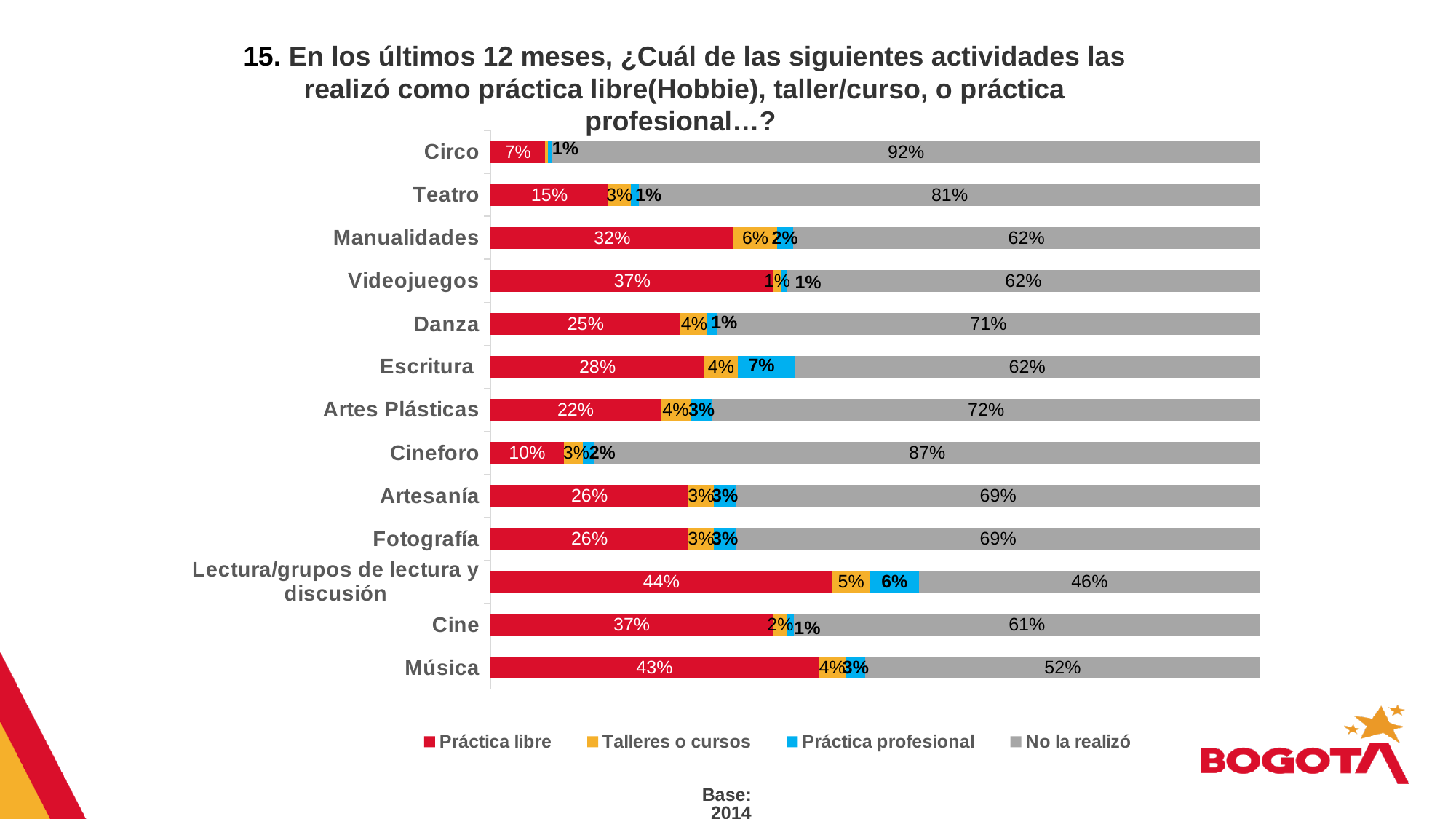
What is the 'Práctica profesional' value for Escritura? 7% Which activity has the lowest 'No la realizó' value? Lectura/grupos de lectura y discusión How many series does the legend list? 4 Which activity has the highest 'Práctica libre' value? Lectura/grupos de lectura y discusión What is the 'No la realizó' value for Circo? 92% How many activities are listed on the chart? 13 Which is larger: the 'Práctica libre' value for Videojuegos or for Manualidades? Videojuegos What kind of chart is shown on the slide? Stacked bar chart What is the 'Práctica libre' value for Música? 43% Which activity has the lowest 'Práctica libre' value? Circo What is the difference between the 'No la realizó' values for Circo and Teatro? 11 percentage points What is the 'Talleres o cursos' value for Manualidades? 6%